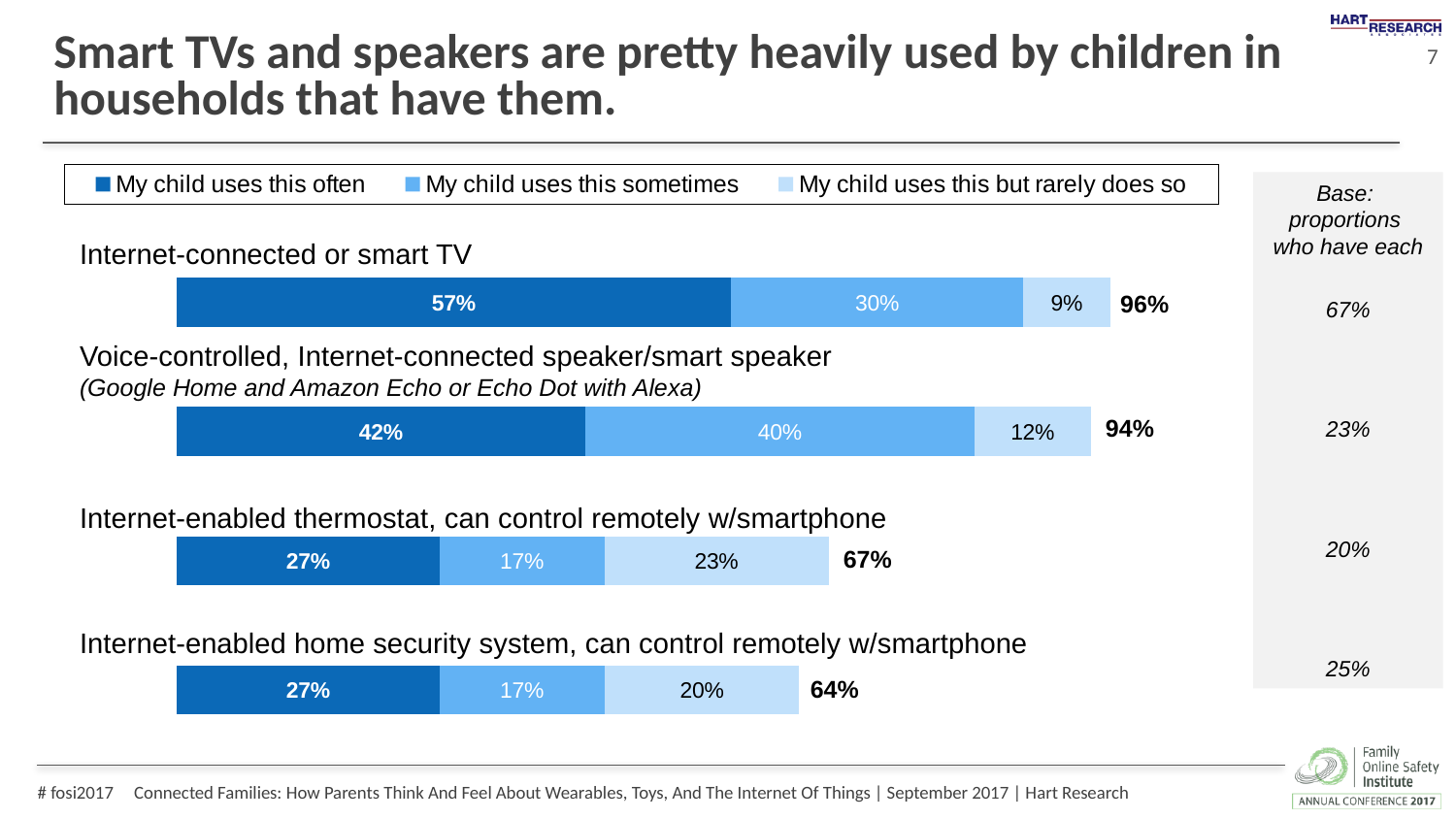
Which is larger: the 'uses this sometimes' share for the smart TV or for the smart speaker? Smart speaker (40%) What percentage of children use the voice-controlled smart speaker sometimes? 40% According to the 'Base' column, what proportion of households have a voice-controlled smart speaker? 23% What percentage of children use the Internet-enabled thermostat but rarely do so? 23% What is the total percentage shown for the Internet-enabled home security system bar? 64% What percentage of children use the Internet-connected or smart TV often? 57% How many devices are shown in the chart? 4 Which device has the lowest total percentage of children using it? Internet-enabled home security system, can control remotely w/smartphone Which device has the highest total percentage of children using it? Internet-connected or smart TV How many series does the legend list? 3 What is the difference between the 'uses this often' percentages for the smart TV and the smart speaker? 15 percentage points What kind of chart is shown on the slide? Stacked horizontal bar chart